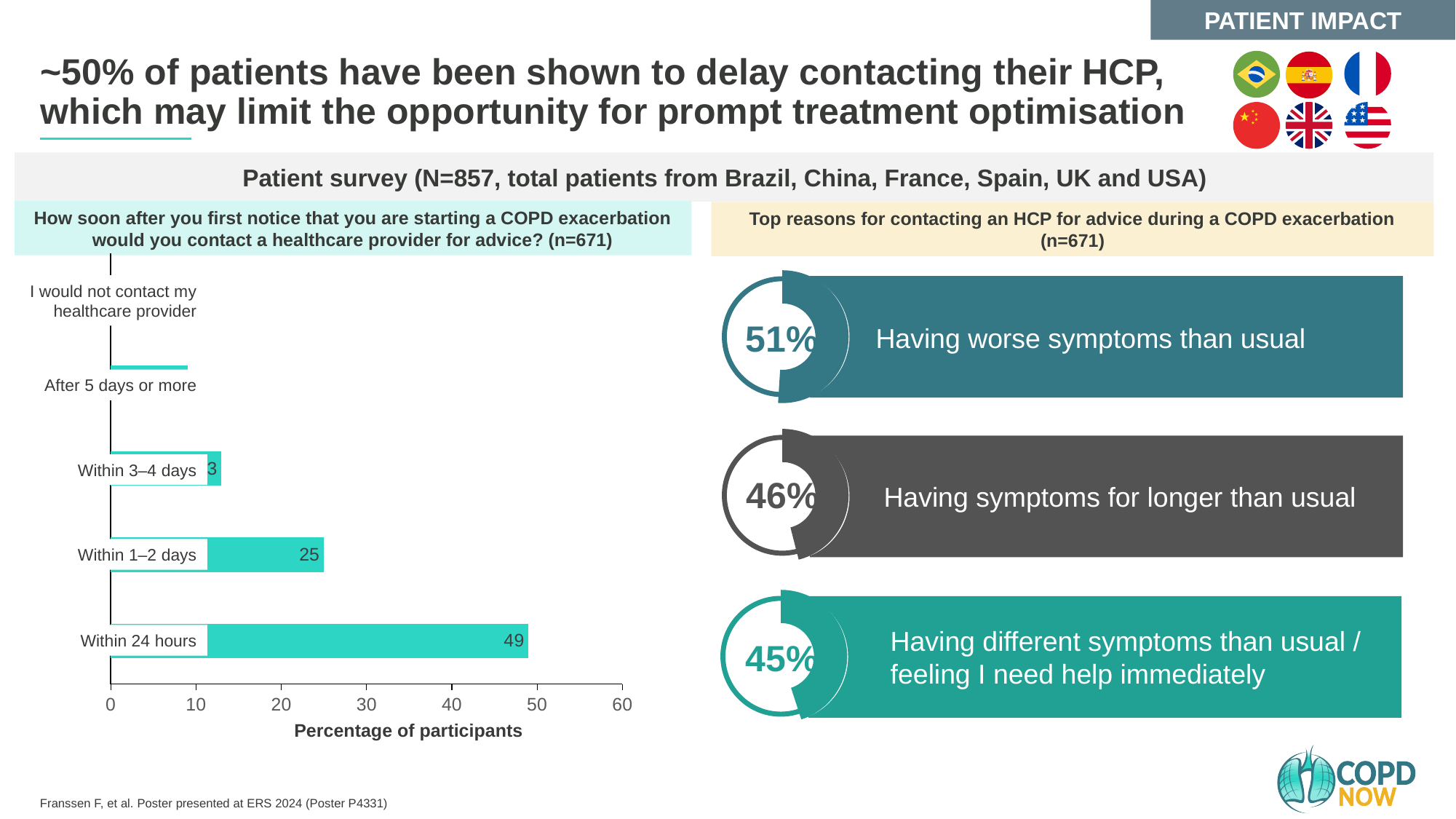
In the bar chart on the left, what is the difference between the values for 'Within 24 hours' and 'Within 1–2 days'? 24 What is the title of the horizontal axis of the bar chart on the left? Percentage of participants In the bar chart on the left, what is the difference between the values for 'Within 1–2 days' and 'Within 3–4 days'? 12 In the bar chart on the left, which is larger: the value for 'Within 1–2 days' or 'Within 3–4 days'? Within 1–2 days In the bar chart on the left, what is the value for 'Within 3–4 days'? 13 How many categories are listed on the vertical axis of the bar chart on the left? 5 In the right panel, what percentage is shown for 'Having worse symptoms than usual'? 51% What type of chart is shown on the left of the slide? bar chart In the bar chart on the left, what percentage of participants would contact a healthcare provider within 24 hours? 49 In the bar chart on the left, what is the value for 'Within 1–2 days'? 25 In the bar chart on the left, which category has the highest percentage of participants? Within 24 hours In the bar chart on the left, is the value for 'Within 24 hours' greater or less than 40? greater